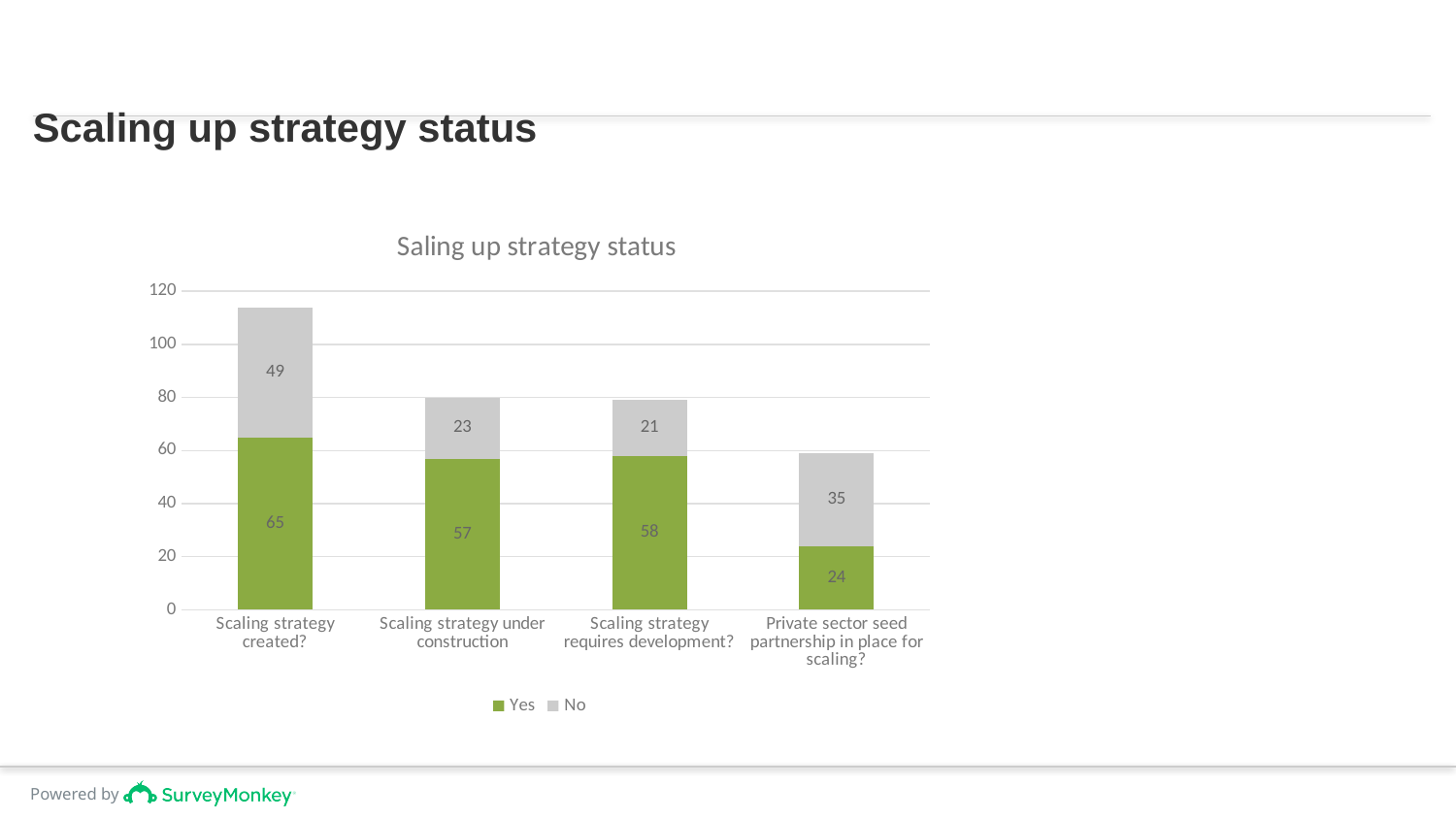
What is the difference between the "Yes" and "No" values for "Scaling strategy created?"? 16 Which category has the lowest "No" value? Scaling strategy requires development? What is the total of the stacked bar for "Scaling strategy requires development?"? 79 How many series does the legend list? 2 What is the "Yes" value for "Scaling strategy created?"? 65 Which category has the highest "Yes" value? Scaling strategy created? What type of chart is shown on the slide? Stacked bar chart How many categories are shown on the x axis? 4 What is the total of the stacked bar for "Scaling strategy created?"? 114 What is the "No" value for "Private sector seed partnership in place for scaling?"? 35 Which is larger for "Private sector seed partnership in place for scaling?": the "Yes" value or the "No" value? No What is the "No" value for "Scaling strategy under construction"? 23